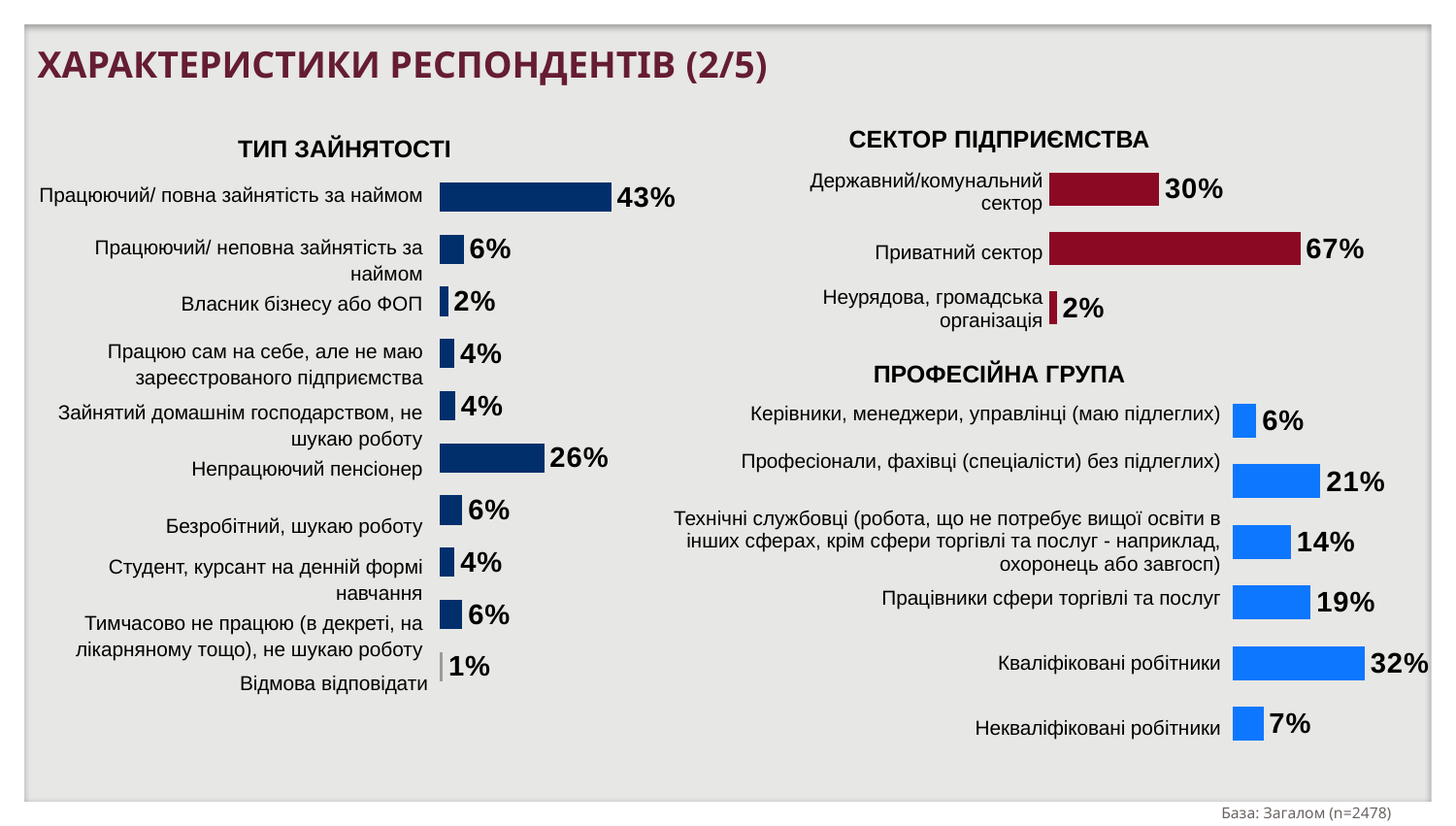
In the 'СЕКТОР ПІДПРИЄМСТВА' chart, what is the difference between 'Приватний сектор' and 'Державний/комунальний сектор'? 37% In the 'ПРОФЕСІЙНА ГРУПА' chart, which is larger: 'Професіонали, фахівці (спеціалісти) без підлеглих' or 'Працівники сфери торгівлі та послуг'? Професіонали, фахівці (спеціалісти) без підлеглих In the 'СЕКТОР ПІДПРИЄМСТВА' chart, what is the value for 'Приватний сектор'? 67% In the 'ТИП ЗАЙНЯТОСТІ' chart, which category has the lowest value? Відмова відповідати In the 'СЕКТОР ПІДПРИЄМСТВА' chart, which category has the highest value? Приватний сектор In the 'ТИП ЗАЙНЯТОСТІ' chart, what is the difference between 'Працюючий/ повна зайнятість за наймом' and 'Непрацюючий пенсіонер'? 17% In the 'ТИП ЗАЙНЯТОСТІ' chart, what is the value for 'Непрацюючий пенсіонер'? 26% In the 'ПРОФЕСІЙНА ГРУПА' chart, how many categories are shown? 6 In the 'ТИП ЗАЙНЯТОСТІ' chart, what is the value for 'Працюючий/ повна зайнятість за наймом'? 43% In the 'ТИП ЗАЙНЯТОСТІ' chart, how many categories are shown? 10 In the 'ПРОФЕСІЙНА ГРУПА' chart, what is the value for 'Кваліфіковані робітники'? 32% What type of chart is the 'ПРОФЕСІЙНА ГРУПА' chart? Bar chart